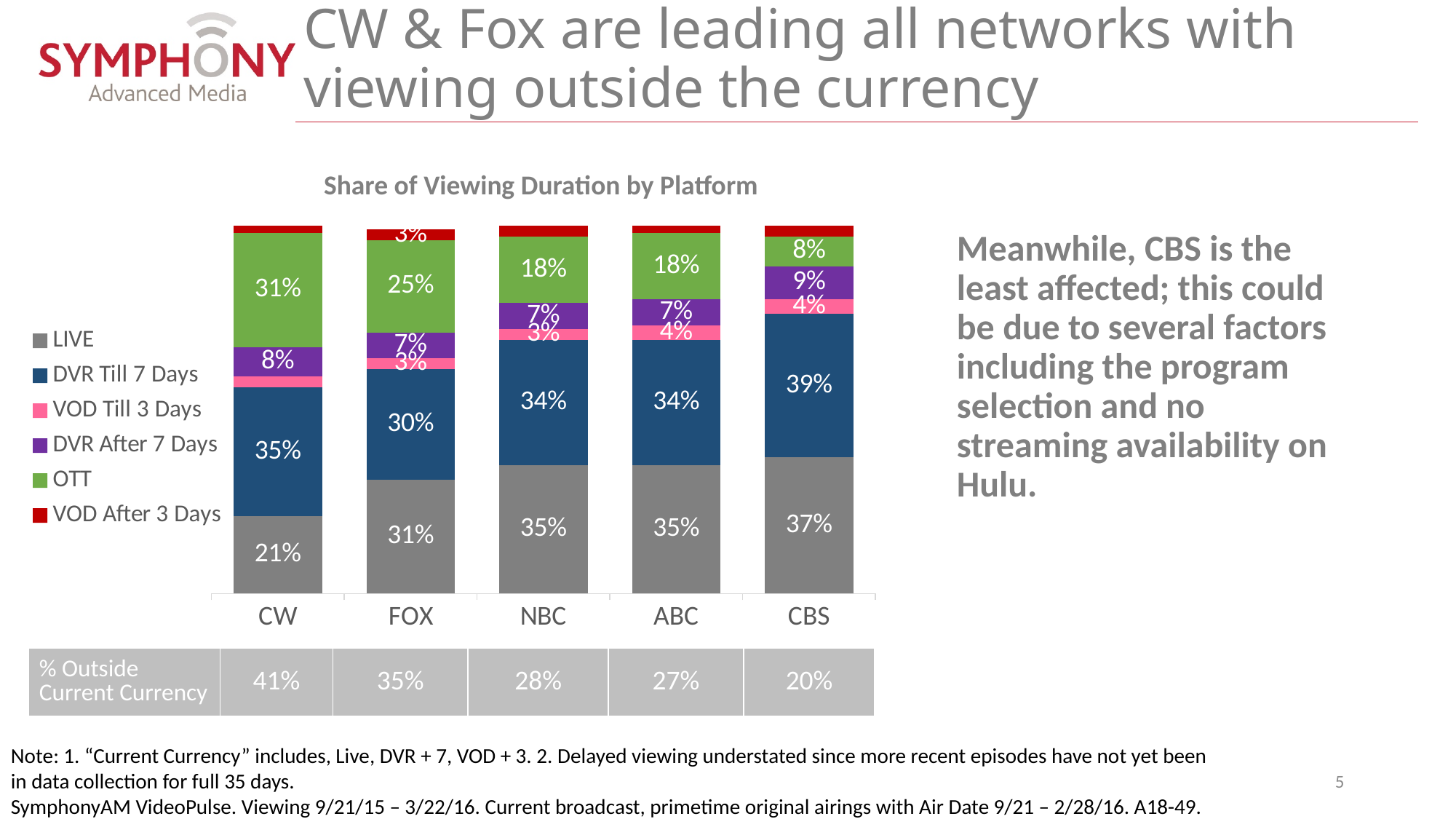
What is the LIVE share for CW? 21% What kind of chart is shown? Stacked bar chart Which network has the lowest LIVE share? CW What is the difference between the OTT share for CW and the OTT share for CBS? 23% What is the OTT share for FOX? 25% How many networks are shown on the x axis? 5 How many series does the legend list? 6 Which is larger, the LIVE share for FOX or the LIVE share for CBS? CBS Which network has the highest OTT share? CW What is the DVR Till 7 Days share for CBS? 39% What is the DVR After 7 Days share for NBC? 7% What is the % Outside Current Currency value for ABC in the table below the chart? 27%